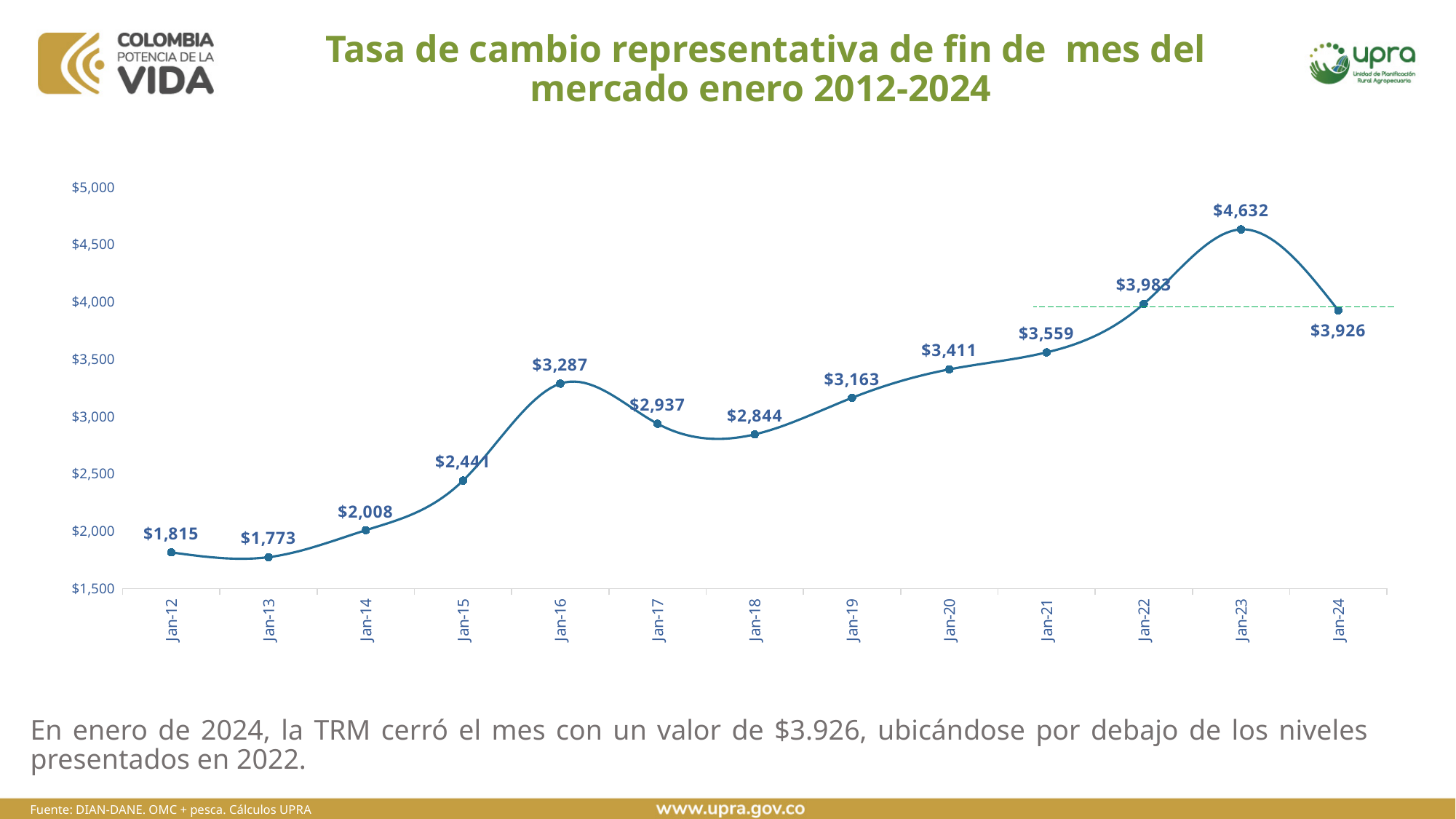
What is the difference between the values for Jan-22 and Jan-21? $424 What is the value for Jan-24? $3,926 What is the value for Jan-16? $3,287 Which point has the lowest value? Jan-13 Do the values rise or fall from Jan-18 to Jan-23? rise What is the value for Jan-12? $1,815 Which point has the highest value? Jan-23 Which is larger, the value for Jan-17 or the value for Jan-18? Jan-17 What is the difference between the values for Jan-23 and Jan-24? $706 How many data points are plotted on the chart? 13 Is the value for Jan-22 greater or less than $4,000? less What kind of chart is shown on the slide? line chart